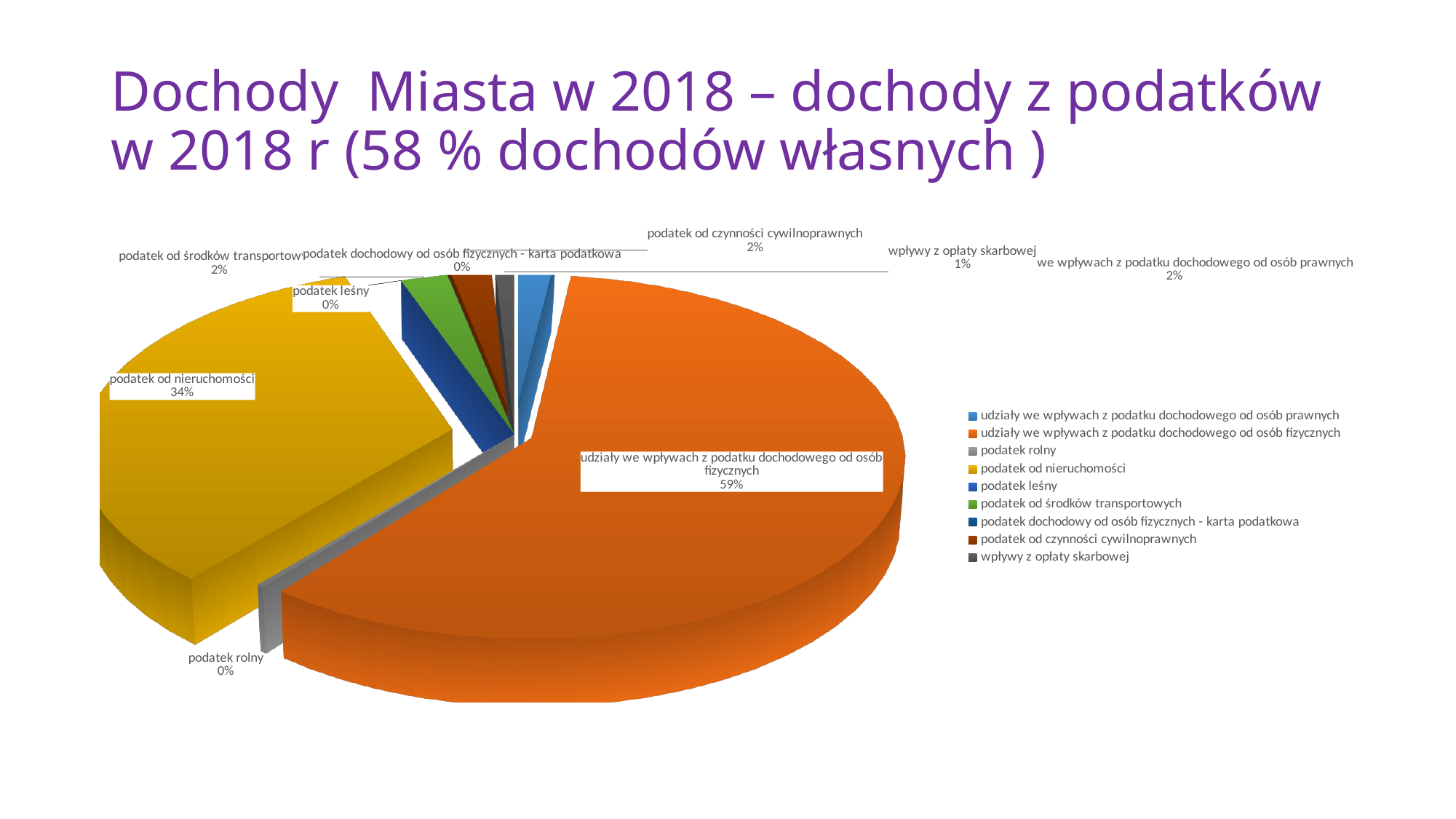
How many entries does the legend list? 9 What share is shown for 'podatek rolny'? 0% What share of the pie does 'udziały we wpływach z podatku dochodowego od osób fizycznych' have? 59% Which category has the largest slice of the pie? udziały we wpływach z podatku dochodowego od osób fizycznych What kind of chart is shown on the slide? pie chart What colour is the slice for 'podatek od nieruchomości'? yellow What share is shown for 'wpływy z opłaty skarbowej'? 1% What share is shown for 'podatek od środków transportowych'? 2% By how many percentage points does 'udziały we wpływach z podatku dochodowego od osób fizycznych' exceed 'podatek od nieruchomości'? 25 percentage points Which is larger: the share for 'podatek od nieruchomości' or the share for 'wpływy z opłaty skarbowej'? podatek od nieruchomości What share of the pie does 'podatek od nieruchomości' have? 34% What share is shown for 'podatek od czynności cywilnoprawnych'? 2%